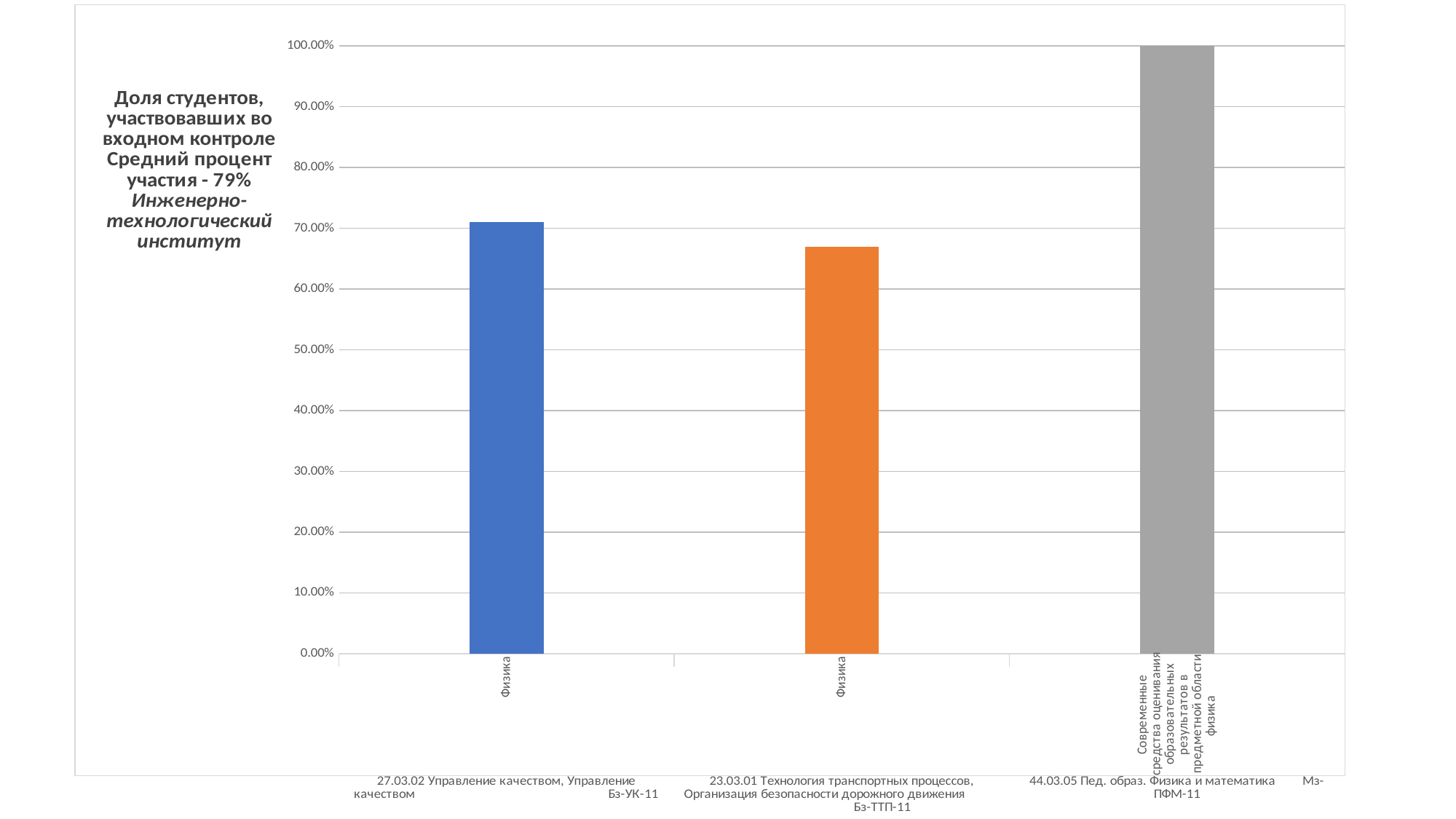
Is the value for group Бз-УК-11 (27.03.02 Управление качеством) greater or less than 70.00%? greater What is the value of the bar for group Мз-ПФМ-11 (44.03.05 Пед. образ. Физика и математика)? 100.00% Is the value for group Бз-УК-11 greater or less than 80.00%? less Which bar is taller: the one for Бз-УК-11 or the one for Бз-ТТП-11? Бз-УК-11 Which group has the lowest bar in the chart? Бз-ТТП-11 What average participation percentage is stated in the chart title? 79% Is the value for group Бз-ТТП-11 (23.03.01 Технология транспортных процессов) greater or less than 70.00%? less Which group has the highest share of students who took part in the entrance control? Мз-ПФМ-11 What kind of chart is shown on the slide? bar chart Which institute is named in the chart title? Инженерно-технологический институт How many bars are plotted in the chart? 3 What is the highest value shown on the vertical axis? 100.00%